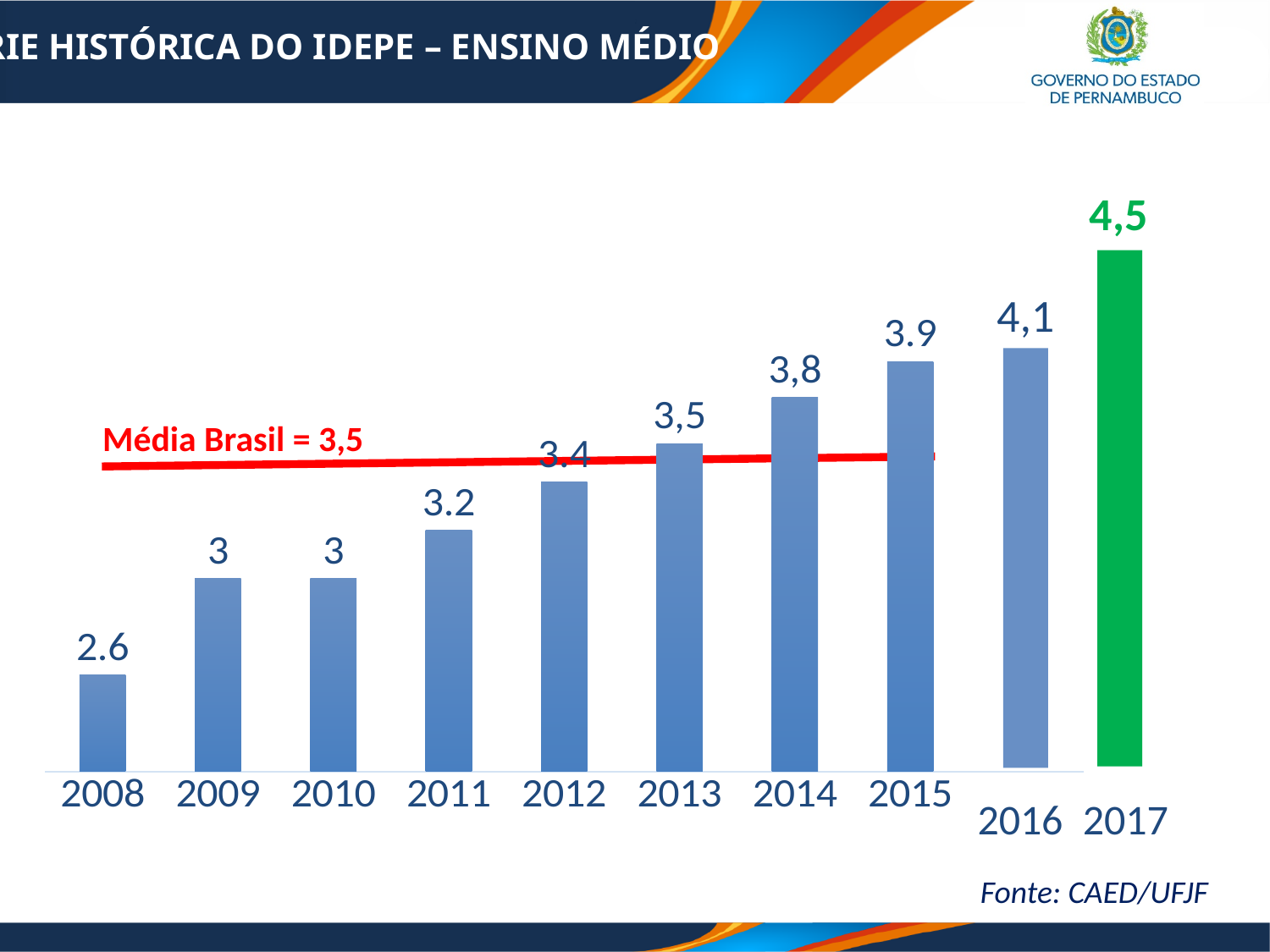
Which year has the highest value? 2017 What is the value shown for 2014? 3,8 What is the value shown for 2017? 4,5 What kind of chart is this? Bar chart What is the difference between the values for 2015 and 2008? 1.3 Which is larger, the value for 2012 or the value for 2013? 2013 Which year has the lowest value? 2008 How many years are shown on the x axis? 10 What is the difference between the values for 2017 and 2016? 0,4 What value does the red line labelled 'Média Brasil' represent? 3,5 What is the value shown for 2011? 3.2 What is the value shown for 2008? 2.6